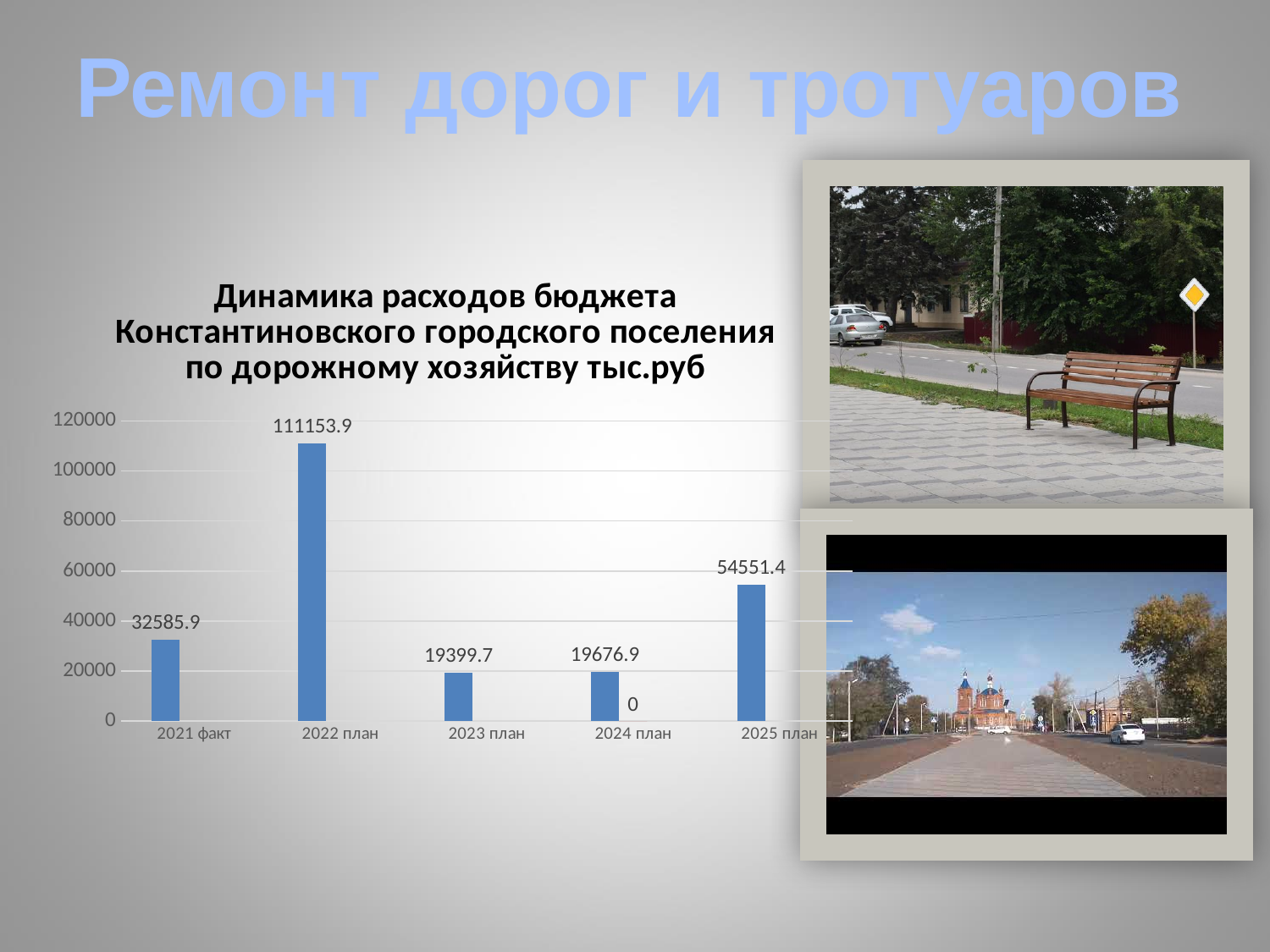
What is the value for 2022 план? 111153.9 Which category has the highest value? 2022 план Which is larger, the value for 2021 факт or the value for 2025 план? 2025 план What is the value for 2023 план? 19399.7 How many categories are shown on the x axis of the chart? 5 Is the value for 2022 план greater or less than 100000? greater What is the difference between the values for 2025 план and 2024 план? 34874.5 What is the difference between the values for 2022 план and 2021 факт? 78568.0 What is the value for 2021 факт? 32585.9 What kind of chart is shown on the slide? bar chart What is the value for 2025 план? 54551.4